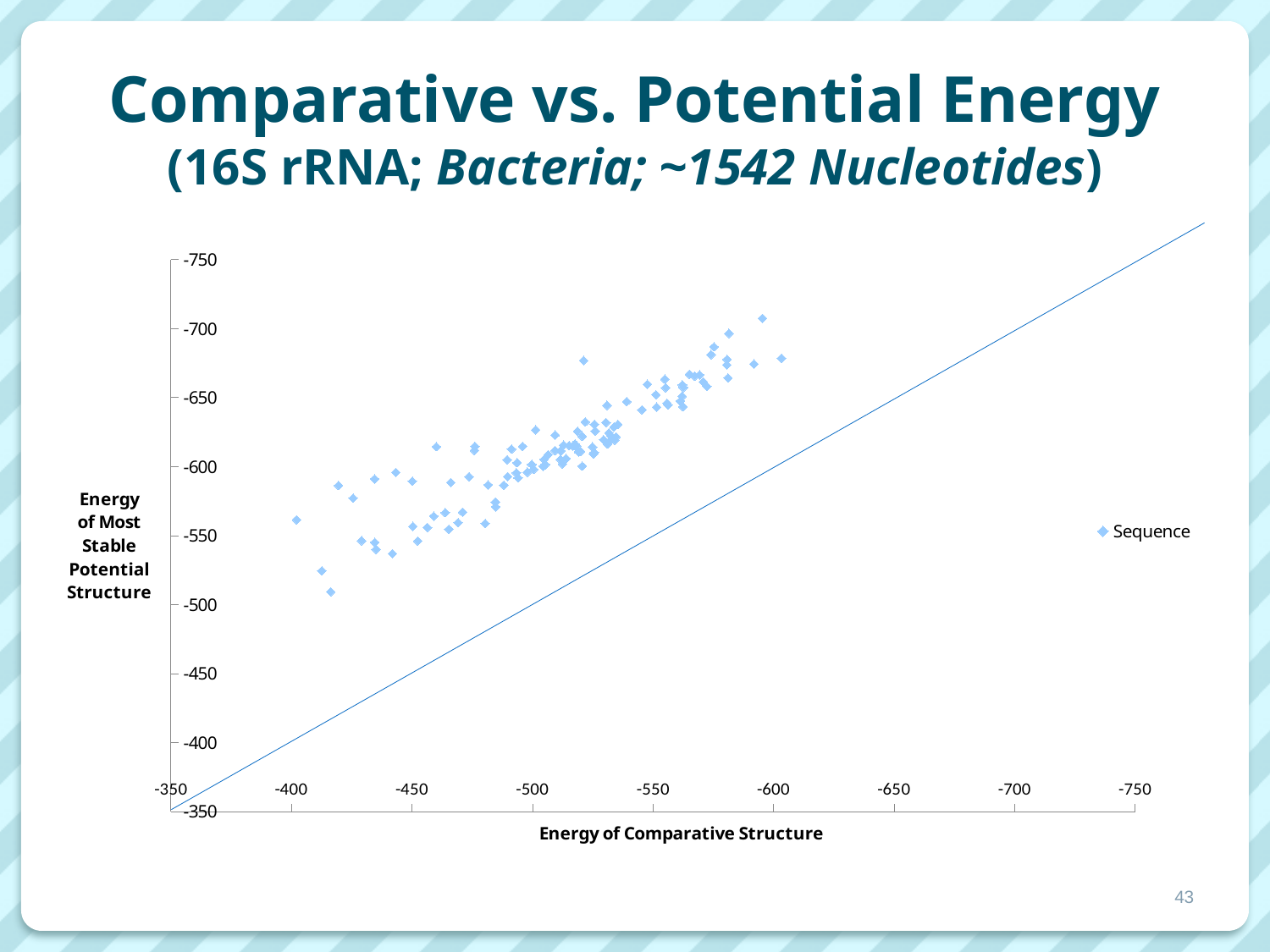
What is the title of the x axis? Energy of Comparative Structure Is the y value of the lowest plotted point greater or less than -550? greater Is the y value of the point plotted highest on the chart greater or less than -700? less Do the plotted points generally rise or fall from left to right along the x axis? rise How many series does the legend list? 1 What kind of chart is shown on the slide? scatter chart What is the name of the series shown in the legend? Sequence Is the x value of the leftmost plotted point greater or less than -450? greater